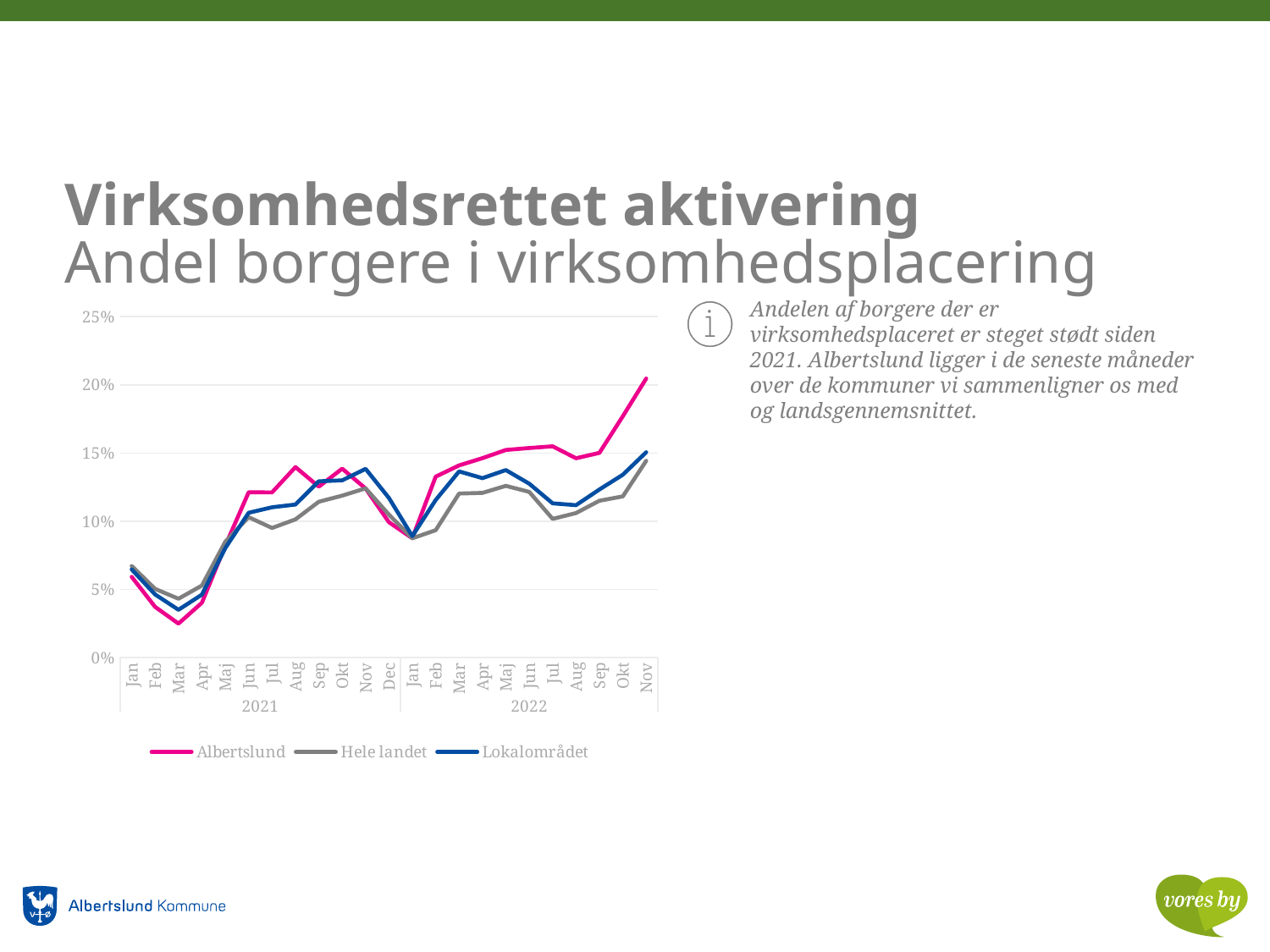
How many series does the legend list? 3 In which month does the Albertslund series reach its lowest value? Mar 2021 Which series are listed in the legend? Albertslund, Hele landet, Lokalområdet How many months are plotted along the x axis? 23 Is the value for Albertslund in Nov 2022 greater or less than 20%? greater Is the value for Hele landet in Nov 2022 greater or less than 15%? less Is the value for Lokalområdet in Jan 2022 greater or less than 10%? less Which series has the highest value in Nov 2022? Albertslund Does the Albertslund series generally rise or fall from Jan 2021 to Nov 2022? rise In Nov 2022, which is larger: the value for Albertslund or the value for Hele landet? Albertslund What kind of chart is shown on the slide? line chart